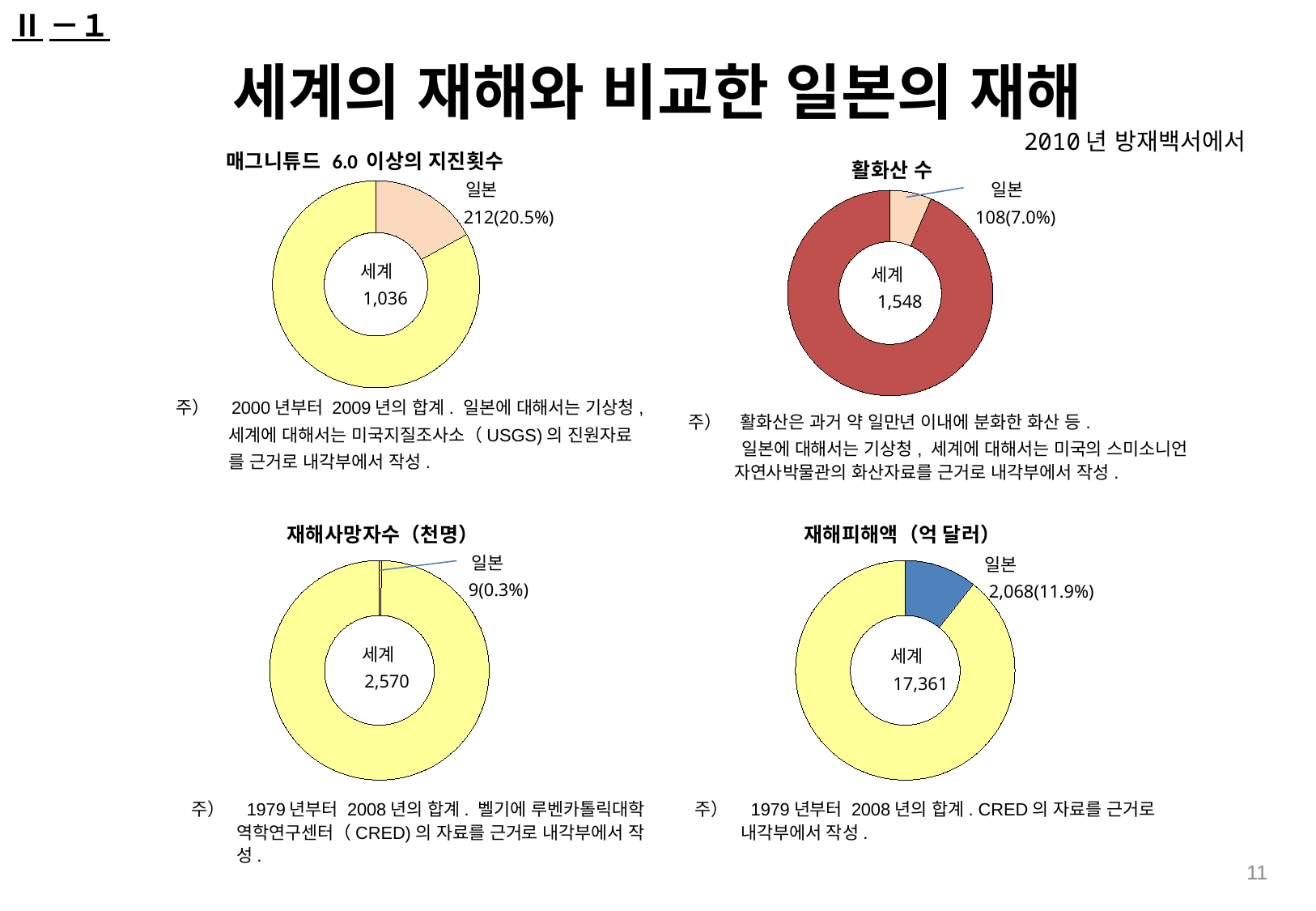
In the chart titled '활화산 수', what is the value shown for 일본? 108 In the chart titled '매그니튜드 6.0 이상의 지진횟수', what is the value shown for 일본? 212 What kind of chart is the chart titled '재해피해액 (억 달러)'? Donut (pie) chart In the chart titled '매그니튜드 6.0 이상의 지진횟수', what is the value shown for 세계? 1,036 How many charts are shown on the slide? 4 In the chart titled '활화산 수', what share of the total does 일본 account for? 7.0% In the chart titled '재해피해액 (억 달러)', what is the value shown for 세계? 17,361 In the chart titled '재해사망자수 (천명)', what is the value shown for 일본? 9 In the chart titled '재해피해액 (억 달러)', what share of the total does 일본 account for? 11.9% In the chart titled '매그니튜드 6.0 이상의 지진횟수', what share of the total does 일본 account for? 20.5% In the chart titled '재해사망자수 (천명)', what is the value shown for 세계? 2,570 In the chart titled '활화산 수', what is the value shown for 세계? 1,548